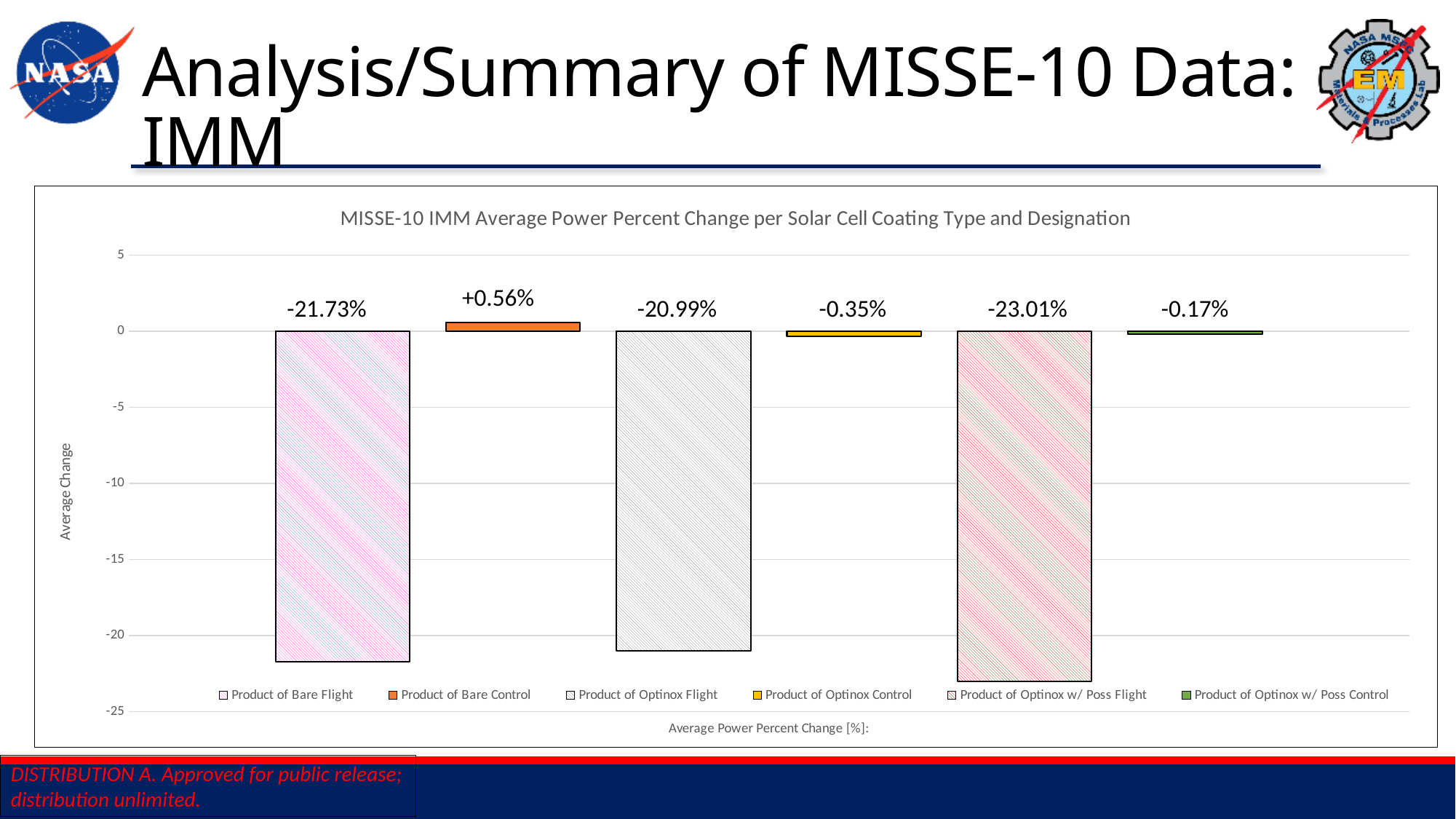
What is the value for Product of Bare Flight? -21.73% What is the value for Product of Bare Control? +0.56% What is the difference between the values for Product of Bare Flight and Product of Optinox Flight? 0.74% How many series does the legend list? 6 Which is larger, the value for Product of Optinox Control or the value for Product of Optinox w/ Poss Control? Product of Optinox w/ Poss Control Which series has the lowest value? Product of Optinox w/ Poss Flight What is the value for Product of Optinox Flight? -20.99% Which series has the highest value? Product of Bare Control What is the title of the chart? MISSE-10 IMM Average Power Percent Change per Solar Cell Coating Type and Designation What is the value for Product of Optinox w/ Poss Control? -0.17% What kind of chart is shown on the slide? Bar chart What is the value for Product of Optinox w/ Poss Flight? -23.01%